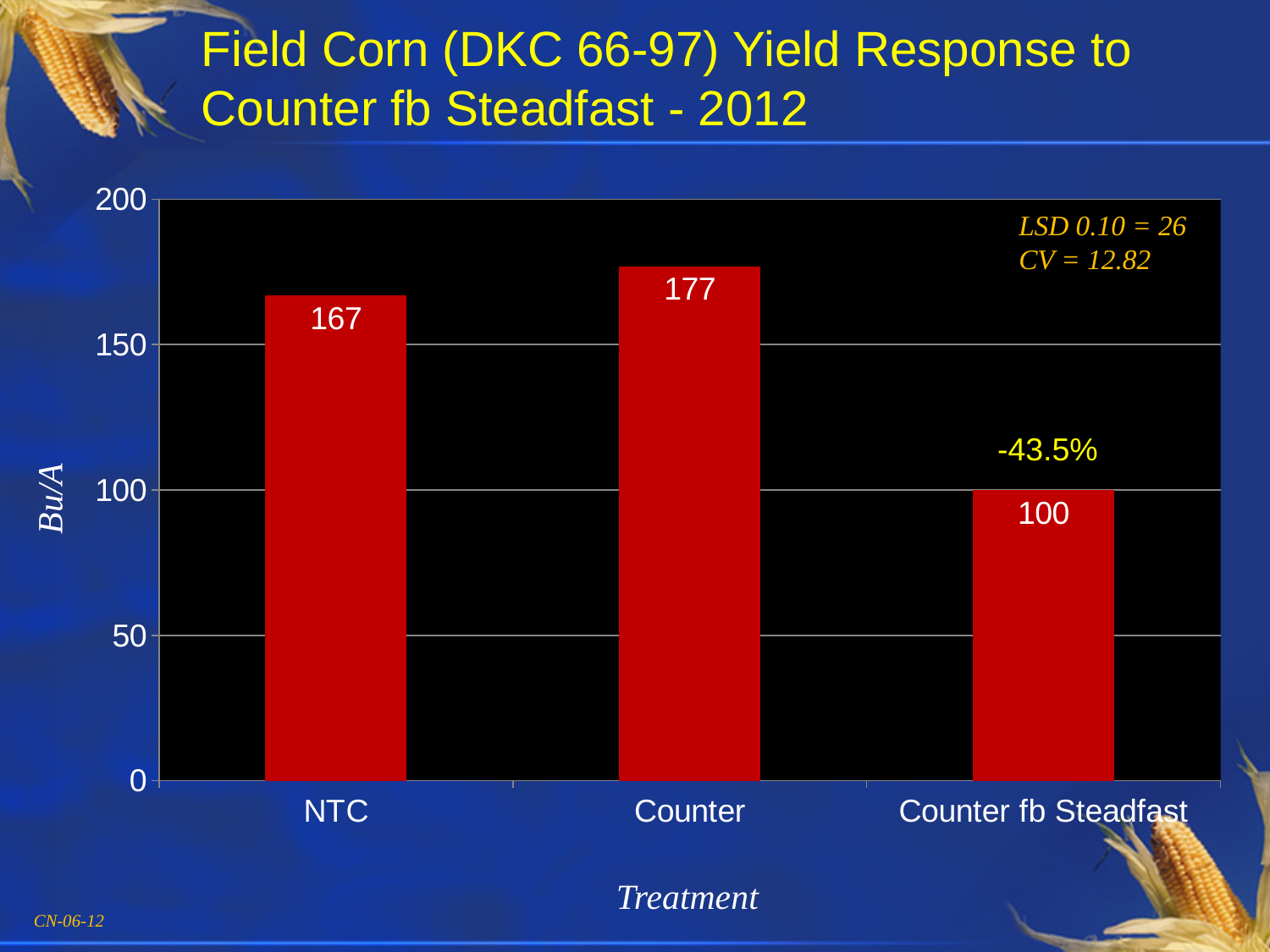
How many treatments are shown on the chart? 3 What is the LSD 0.10 value shown on the chart? 26 What is the yield (Bu/A) for the NTC treatment? 167 What is the difference in yield between NTC and Counter fb Steadfast? 67 What kind of chart is shown on the slide? Bar chart Which treatment has the lowest yield? Counter fb Steadfast What is the yield (Bu/A) for the Counter treatment? 177 What percentage change is labelled above the Counter fb Steadfast bar? -43.5% What is the difference in yield between Counter and NTC? 10 Which treatment has the highest yield? Counter Which has a larger yield, NTC or Counter fb Steadfast? NTC What is the yield (Bu/A) for the Counter fb Steadfast treatment? 100